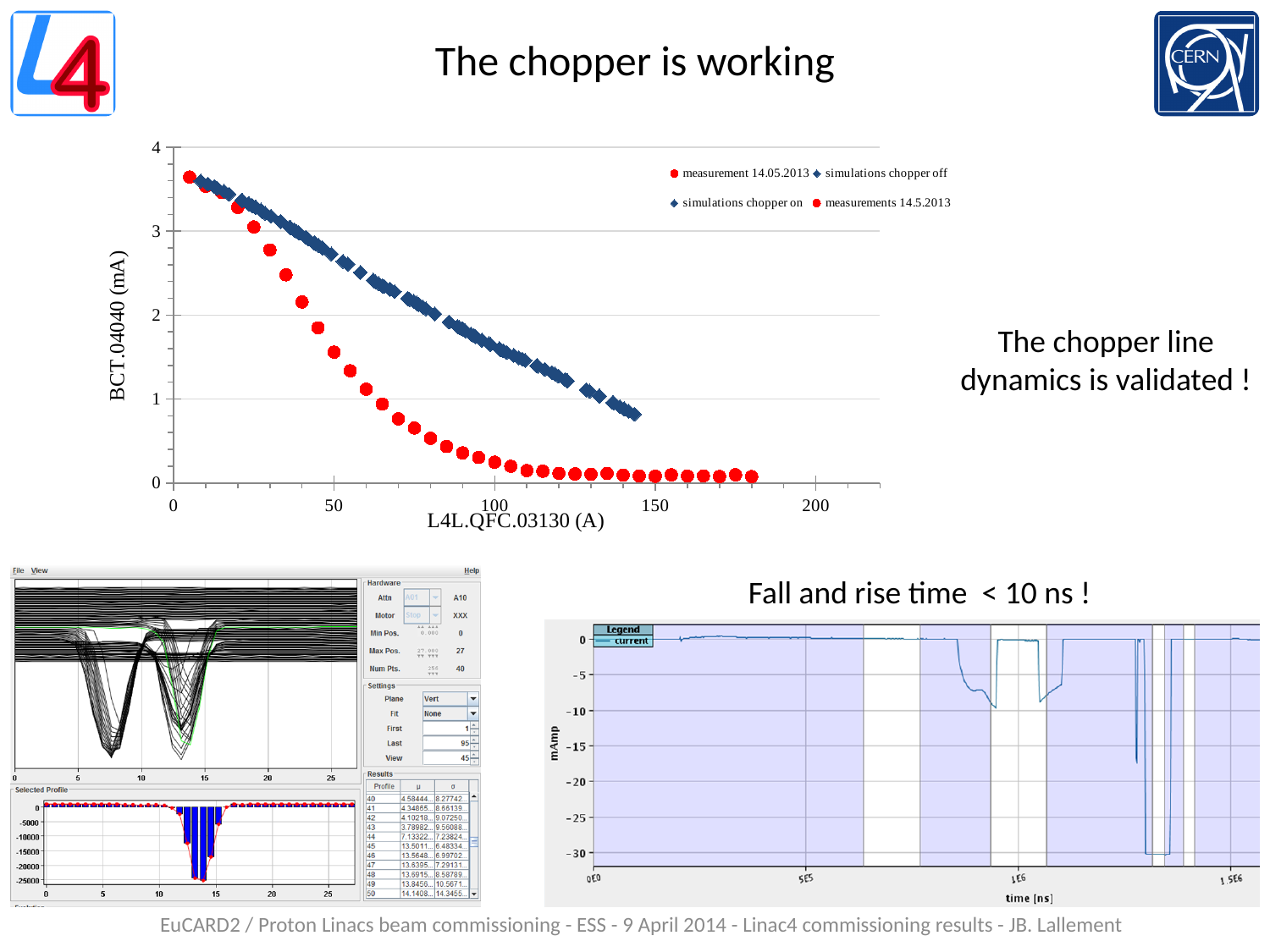
In the bottom-right chart of current versus time [ns], is the lowest plotted value greater or less than -25? less In the top chart, is the red measurement value at 100 A greater or less than 1? less In the top chart, is the blue simulation value at 100 A greater or less than 1? greater In the top chart, how many series does the legend list? 4 In the top chart, what is the title of the x axis? L4L.QFC.03130 (A) What kind of chart is the top chart plotting BCT.04040 (mA) against L4L.QFC.03130 (A)? scatter chart In the top chart, do the plotted values rise or fall as L4L.QFC.03130 (A) increases? fall In the top chart, at 75 A, which is higher: the blue simulation series or the red measurement series? the blue simulation series In the bottom-right chart of current versus time [ns], what is the single entry in the legend? current